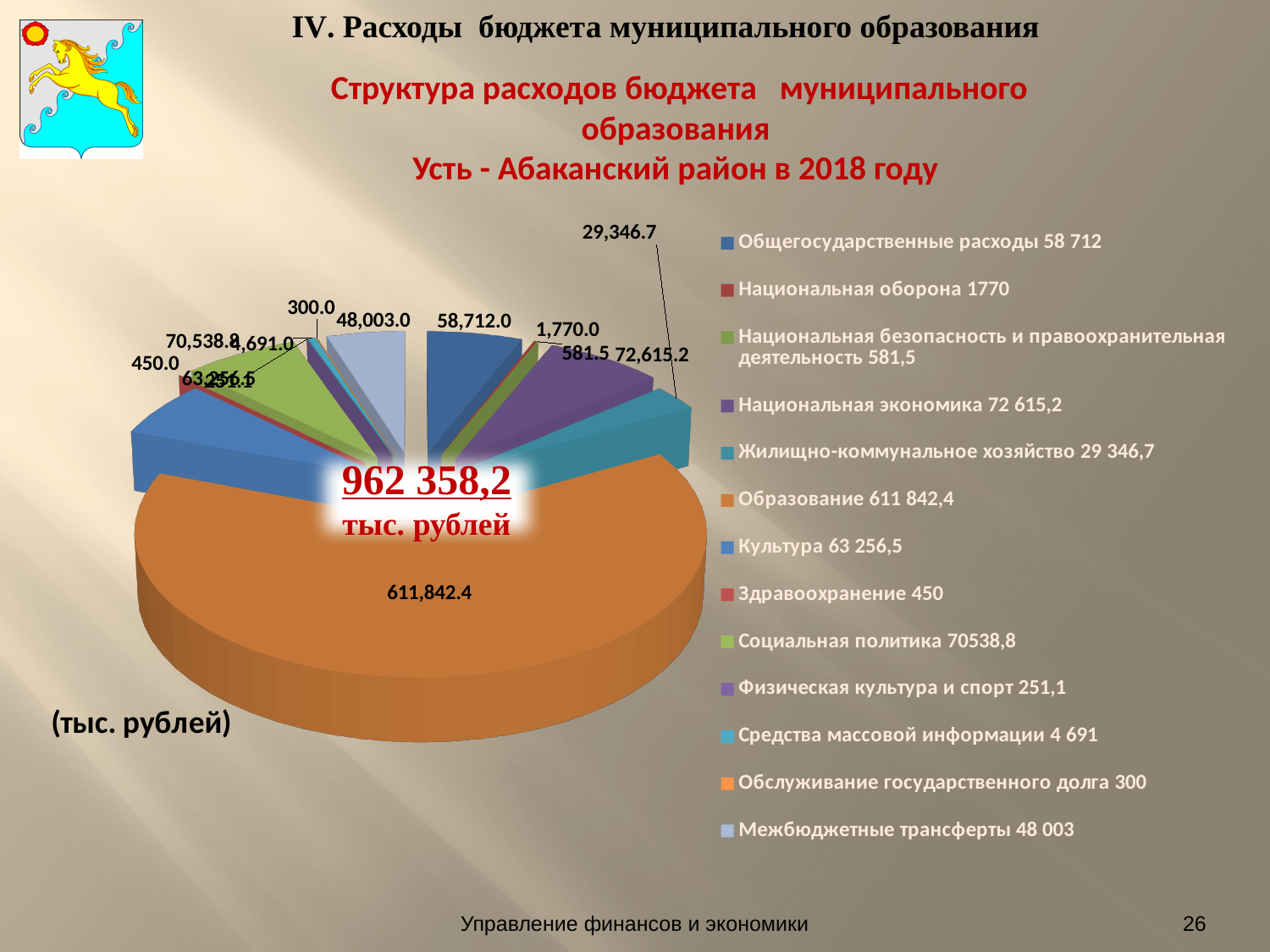
What is the value shown for Межбюджетные трансферты? 48,003.0 What total value is printed in the centre of the pie chart? 962 358,2 тыс. рублей How many categories does the pie chart show? 13 What share of the total (962 358,2) does Образование (611,842.4) represent, to one decimal place? 63.6% Which category has the largest slice of the pie chart? Образование What is the value shown for Национальная экономика? 72,615.2 Which is larger, Национальная экономика or Общегосударственные расходы? Национальная экономика What is the value shown for Жилищно-коммунальное хозяйство? 29,346.7 What is the difference between Национальная экономика (72,615.2) and Общегосударственные расходы (58,712.0)? 13,903.2 What is the value shown for Образование? 611,842.4 Which category has the smallest value in the pie chart? Физическая культура и спорт What kind of chart is shown on the slide? pie chart